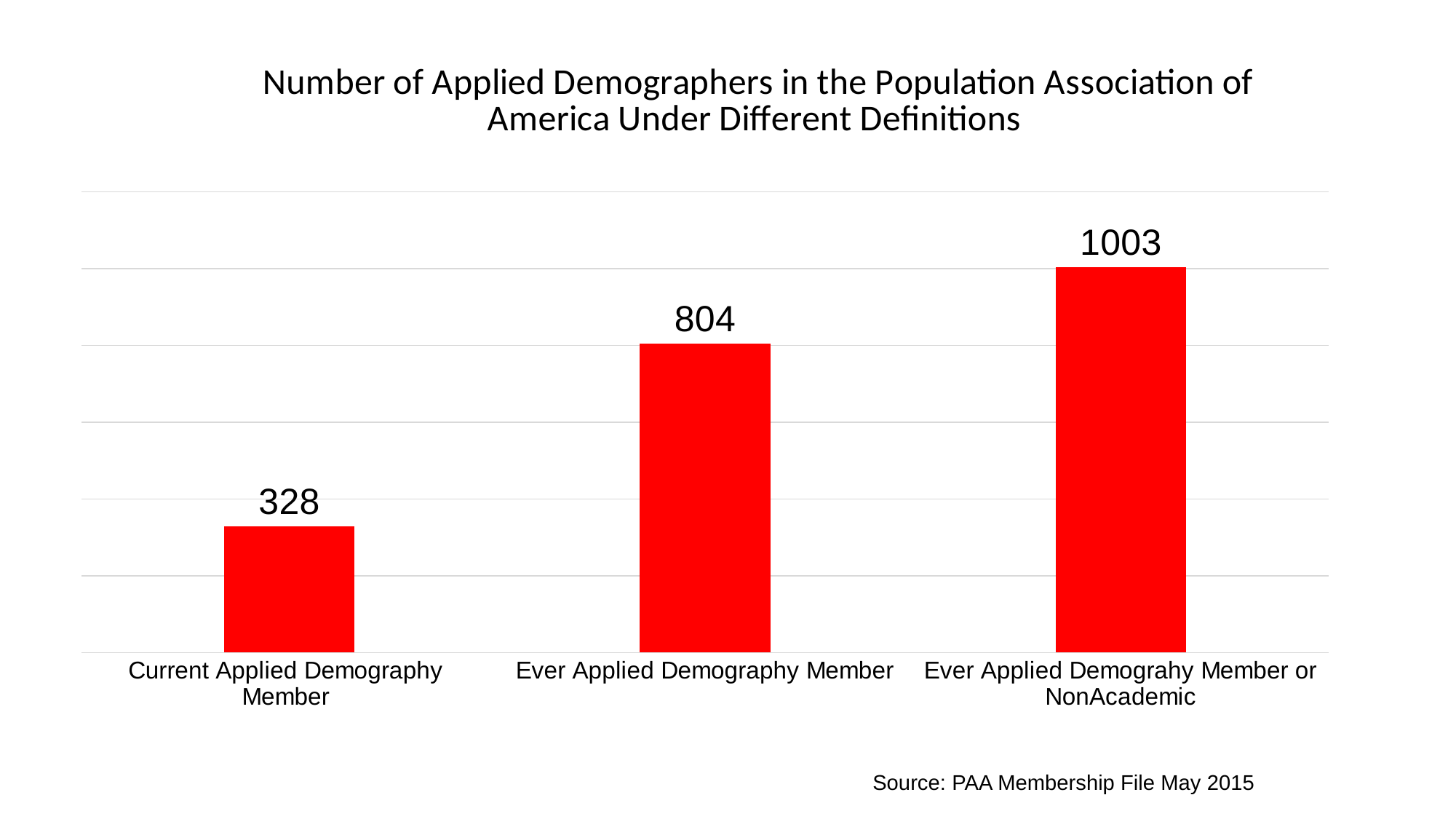
What is the value for Ever Applied Demograhy Member or NonAcademic? 1003 What is the value for Ever Applied Demography Member? 804 What source is cited for the chart's data? PAA Membership File May 2015 What is the value for Current Applied Demography Member? 328 Which category has the highest value? Ever Applied Demograhy Member or NonAcademic What kind of chart is shown on the slide? Bar chart What is the difference between the values for Ever Applied Demograhy Member or NonAcademic and Ever Applied Demography Member? 199 Which category has the lowest value? Current Applied Demography Member Which is larger, the value for Ever Applied Demography Member or the value for Current Applied Demography Member? Ever Applied Demography Member What is the difference between the values for Ever Applied Demography Member and Current Applied Demography Member? 476 Do the values rise or fall from left to right across the categories? Rise How many categories are shown in the chart? 3